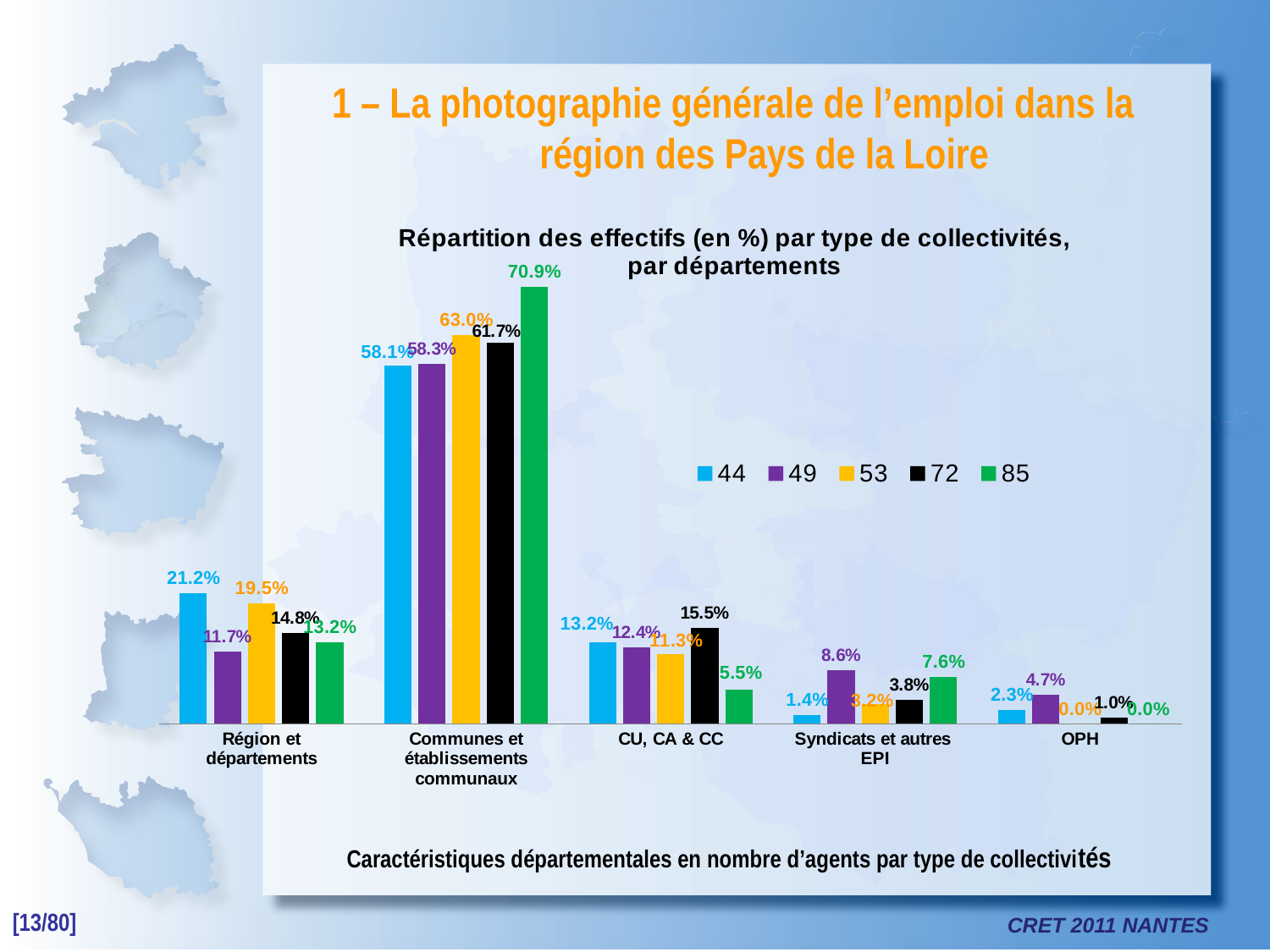
Which colour represents département 53 in the legend? Yellow In the CU, CA & CC category, which is larger: the value for département 72 or the value for département 85? 72 What is the value for département 85 in the Communes et établissements communaux category? 70.9% How many series does the legend list? 5 What is the value for département 72 in the CU, CA & CC category? 15.5% What is the value for département 44 in the Région et départements category? 21.2% Which département has the lowest value in the Syndicats et autres EPI category? 44 What is the value for département 49 in the Syndicats et autres EPI category? 8.6% What is the difference between the values for département 44 and département 49 in the Région et départements category? 9.5% How many categories of collectivités are shown on the x axis? 5 What kind of chart is shown on the slide? Bar chart Which département has the highest value in the Communes et établissements communaux category? 85